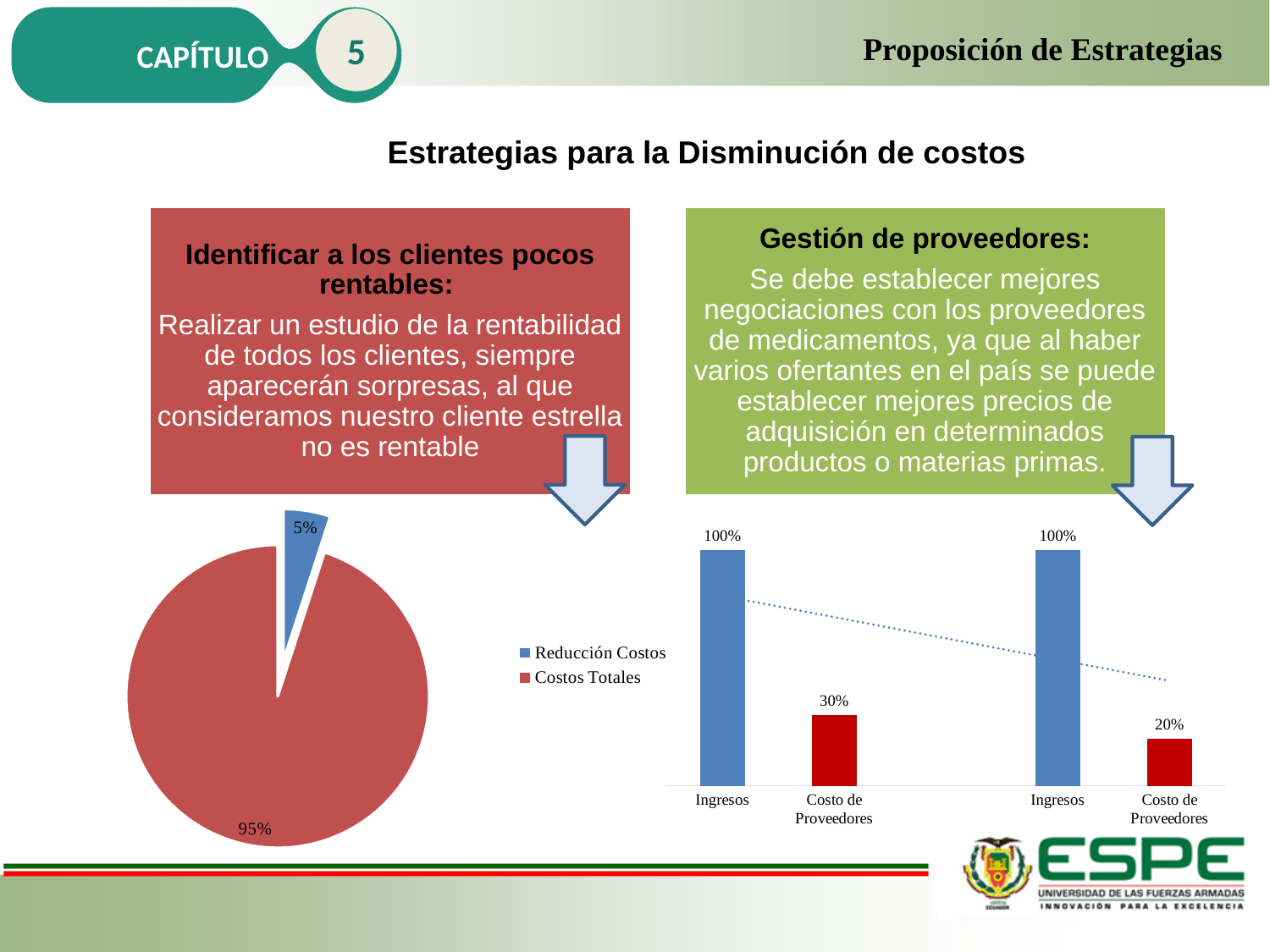
In the pie chart on the left, what colour is the Costos Totales slice? Red In the bar chart on the right, what is the value of the second Costo de Proveedores bar? 20% In the pie chart on the left, what share does Reducción Costos have? 5% In the pie chart on the left, which slice is the smallest? Reducción Costos In the bar chart on the right, how many bars are plotted? 4 In the bar chart on the right, what is the value of the first Costo de Proveedores bar? 30% In the pie chart on the left, what share does Costos Totales have? 95% In the pie chart on the left, how many series does the legend list? 2 What kind of chart is shown on the right of the slide? Bar chart What kind of chart is shown on the left of the slide? Pie chart In the bar chart on the right, what is the difference between the first Ingresos bar and the first Costo de Proveedores bar? 70% In the pie chart on the left, which slice is the largest? Costos Totales